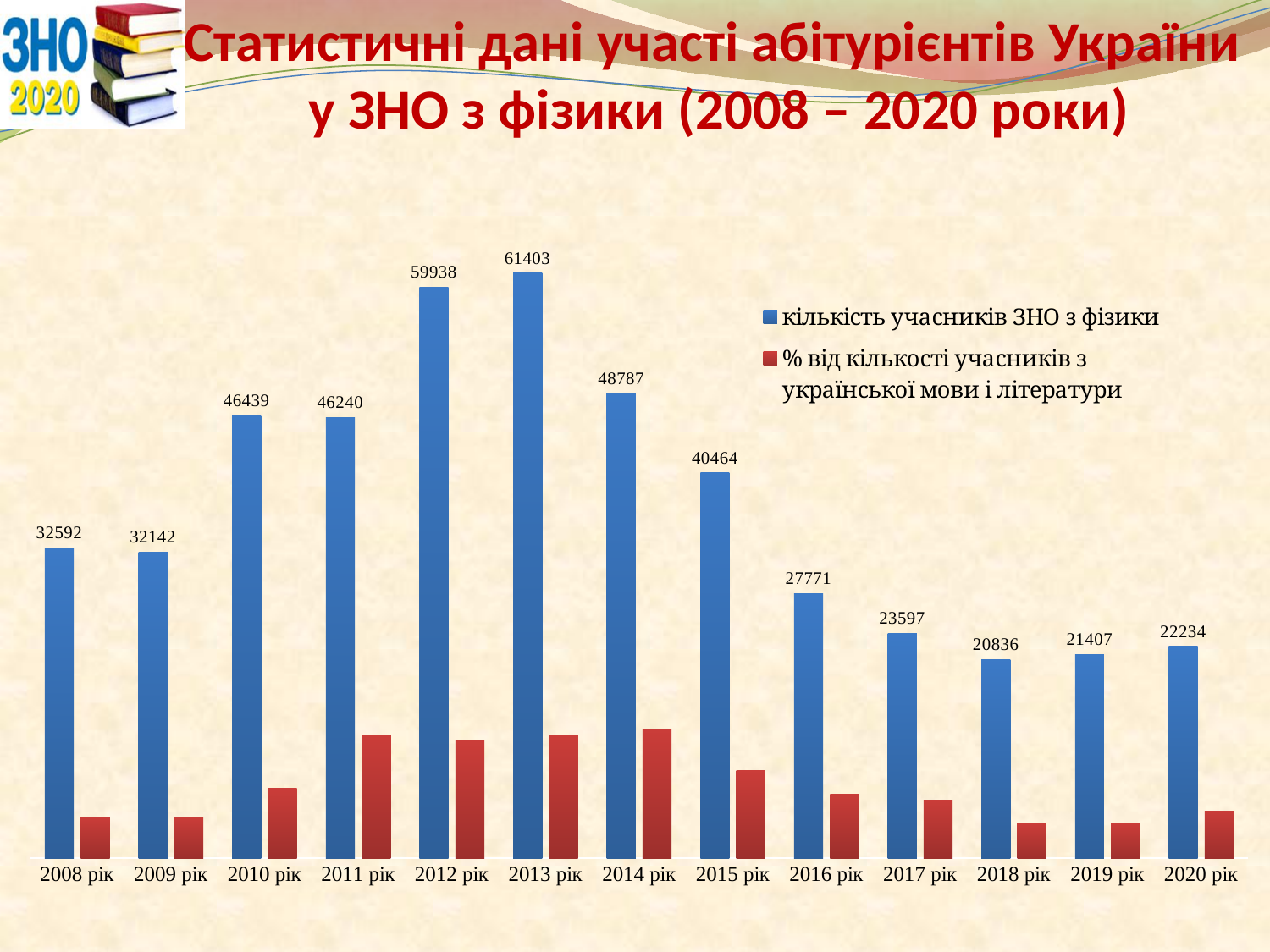
What is the difference between the number of physics ZNO participants in 2013 рік and 2012 рік? 1465 Does the number of physics ZNO participants rise or fall from 2013 рік to 2018 рік? Fall Which year has the highest number of physics ZNO participants? 2013 рік What is the difference between the number of physics ZNO participants in 2020 рік and 2019 рік? 827 How many series does the chart legend list? 2 What is the number of physics ZNO participants shown for 2020 рік? 22234 What kind of chart is shown on the slide? Bar chart What is the number of physics ZNO participants (кількість учасників ЗНО з фізики) in 2013 рік? 61403 What is the number of physics ZNO participants shown for 2008 рік? 32592 Which year has the lowest number of physics ZNO participants? 2018 рік How many years (categories) are shown on the x axis of the chart? 13 Which year had more physics ZNO participants, 2014 рік or 2015 рік? 2014 рік